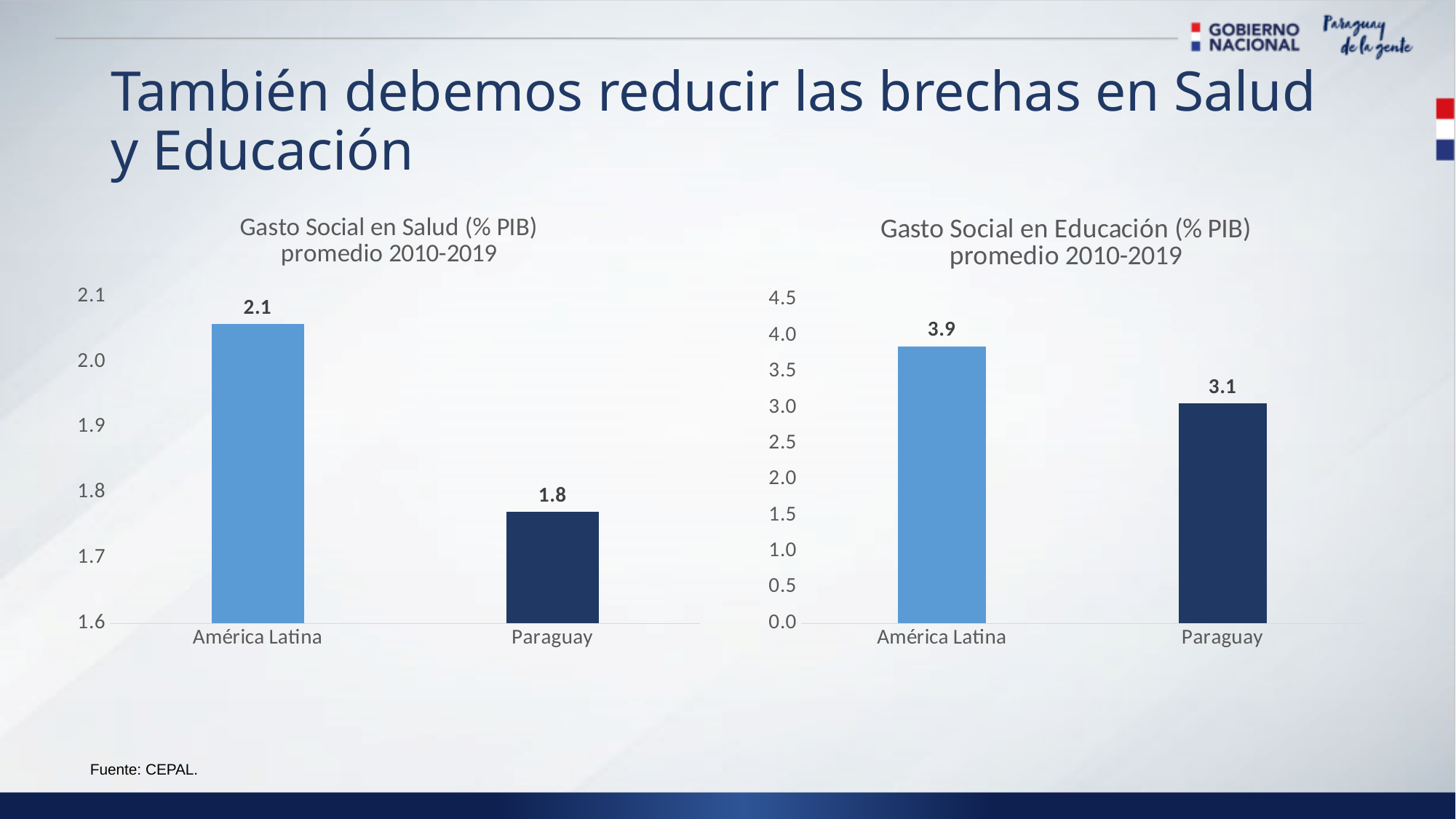
In the 'Gasto Social en Salud (% PIB) promedio 2010-2019' chart, what is the difference between the values for América Latina and Paraguay? 0.3 How many categories are shown in the 'Gasto Social en Salud (% PIB) promedio 2010-2019' chart? 2 In the 'Gasto Social en Salud (% PIB) promedio 2010-2019' chart, what is the value for Paraguay? 1.8 In the 'Gasto Social en Salud (% PIB) promedio 2010-2019' chart, which category has the highest value? América Latina In the 'Gasto Social en Educación (% PIB) promedio 2010-2019' chart, is the value for Paraguay greater or less than 3.5? less In the 'Gasto Social en Educación (% PIB) promedio 2010-2019' chart, what is the difference between the values for América Latina and Paraguay? 0.8 In the 'Gasto Social en Educación (% PIB) promedio 2010-2019' chart, what is the value for América Latina? 3.9 In the 'Gasto Social en Salud (% PIB) promedio 2010-2019' chart, what is the value for América Latina? 2.1 In the 'Gasto Social en Educación (% PIB) promedio 2010-2019' chart, which is larger, the value for América Latina or for Paraguay? América Latina In the 'Gasto Social en Educación (% PIB) promedio 2010-2019' chart, what is the value for Paraguay? 3.1 What kind of chart is the 'Gasto Social en Educación (% PIB) promedio 2010-2019' chart? Bar chart In the 'Gasto Social en Educación (% PIB) promedio 2010-2019' chart, which category has the lowest value? Paraguay